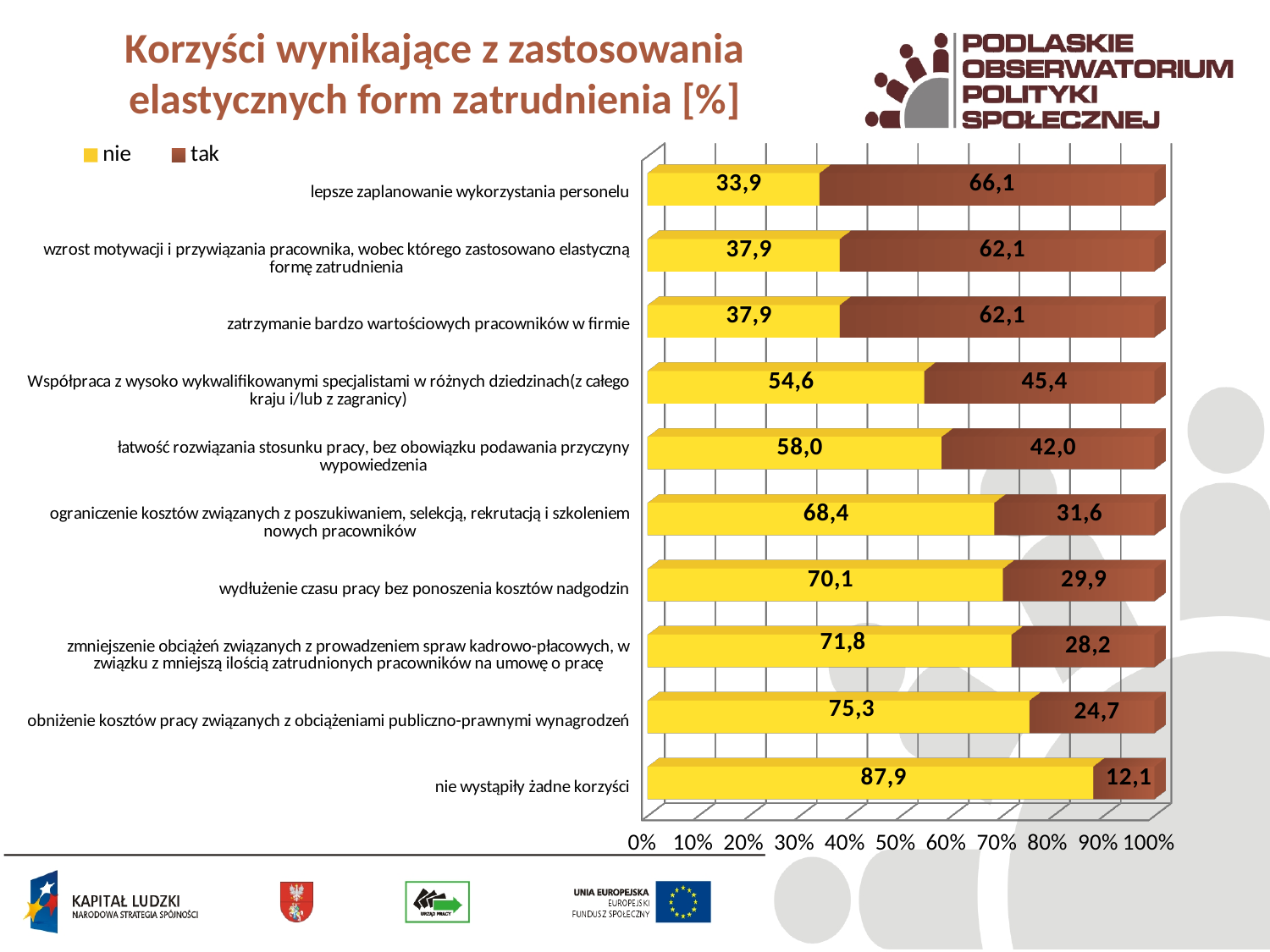
Which is larger for "Współpraca z wysoko wykwalifikowanymi specjalistami w różnych dziedzinach": the "nie" value or the "tak" value? nie What is the "tak" value for "lepsze zaplanowanie wykorzystania personelu"? 66,1 What is the "nie" value for "nie wystąpiły żadne korzyści"? 87,9 How many series does the legend list? 2 Which colour represents the "tak" series in the chart? brown What kind of chart is shown on the slide? stacked bar chart What is the difference between the "nie" and "tak" values for "obniżenie kosztów pracy związanych z obciążeniami publiczno-prawnymi wynagrodzeń"? 50,6 What is the total of the stacked bar for "łatwość rozwiązania stosunku pracy, bez obowiązku podawania przyczyny wypowiedzenia"? 100,0 How many categories are shown in the chart? 10 Which category has the lowest "tak" value? nie wystąpiły żadne korzyści What is the "nie" value for "wydłużenie czasu pracy bez ponoszenia kosztów nadgodzin"? 70,1 Which category has the highest "tak" value? lepsze zaplanowanie wykorzystania personelu